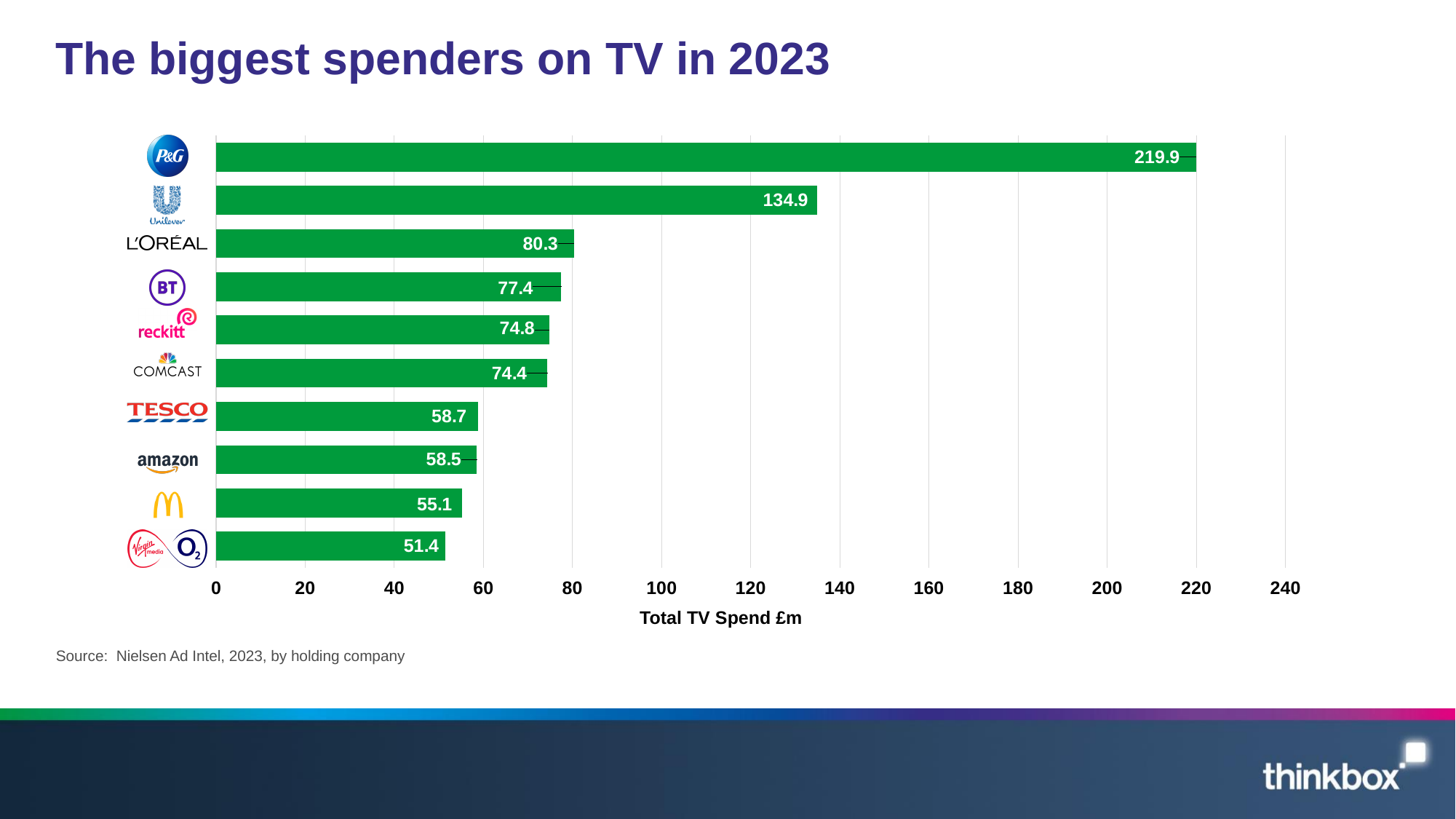
Which company has the highest total TV spend? P&G Which company has the lowest total TV spend? Virgin Media O2 What is the total TV spend for P&G? 219.9 What is the total TV spend for Tesco? 58.7 What is the total TV spend for Unilever? 134.9 What is the label of the horizontal axis? Total TV Spend £m What is the difference in total TV spend between P&G and Unilever? 85.0 What is the total TV spend for McDonald's? 55.1 How many companies are shown in the chart? 10 What is the difference in total TV spend between L'Oréal and BT? 2.9 What type of chart is shown on the slide? Bar chart Which has a larger total TV spend, Unilever or L'Oréal? Unilever